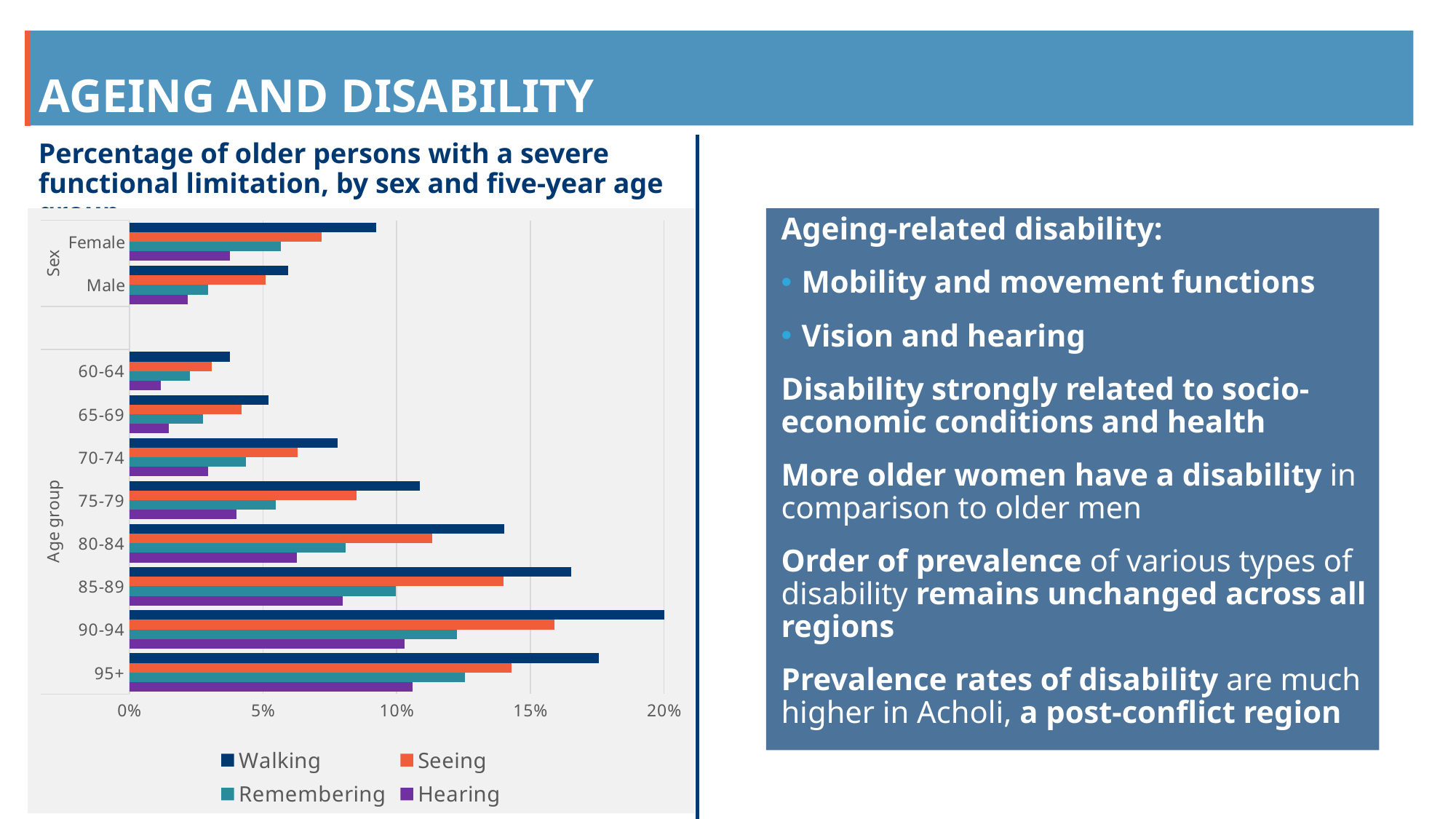
Which age group has the lowest Walking value? 60-64 What kind of chart is shown on the slide? Bar chart How many series does the chart legend list? 4 Which series is shown in dark blue in the legend? Walking Is the Seeing value for the 90-94 age group greater or less than 15%? greater How many categories (sex groups plus age groups) are plotted on the chart? 10 Which has the larger Walking value, Female or Male? Female Is the Walking value for the 80-84 age group greater or less than 15%? less Do the Walking values generally rise or fall from the 60-64 age group to the 90-94 age group? rise Is the Hearing value for the 60-64 age group greater or less than 5%? less Which age group has the highest Walking value? 90-94